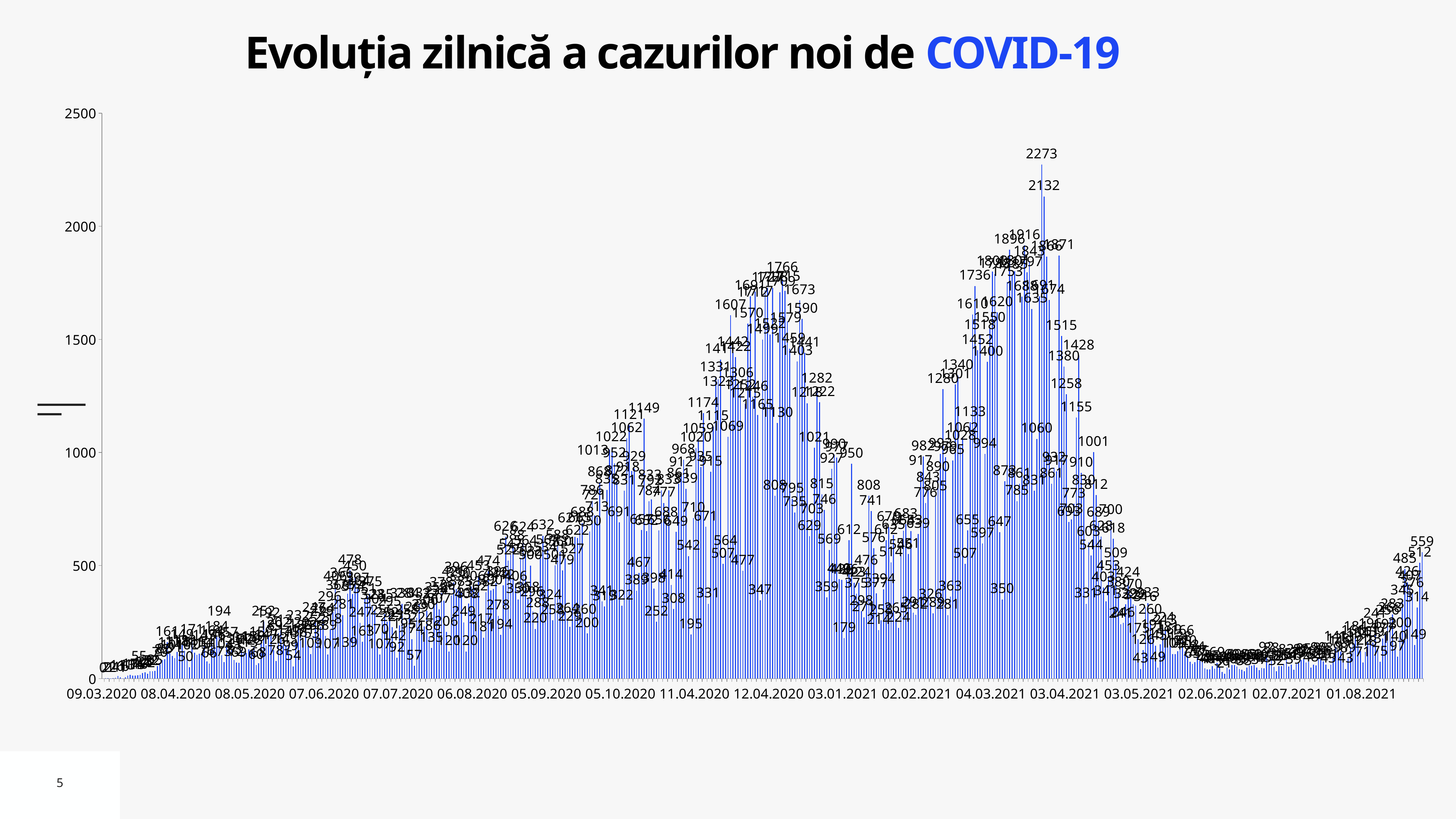
What is the first date label on the x axis? 09.03.2020 What is the title of the chart? Evoluția zilnică a cazurilor noi de COVID-19 What is the maximum value shown on the y axis? 2500 What is the highest daily value shown in the chart? 2273 Is the value of the rightmost bar greater or less than 1000? less What is the value of the second-tallest bar in the chart? 2132 What is the difference between the two tallest bars, labelled 2273 and 2132? 141 What kind of chart is shown on the slide? bar chart Is the value of the tallest bar near 07.06.2020 greater or less than 500? less Which is larger, the tallest bar near 03.04.2021 or the tallest bar near 12.04.2020? the tallest bar near 03.04.2021 Is the tallest bar in the chart greater or less than 2000? greater